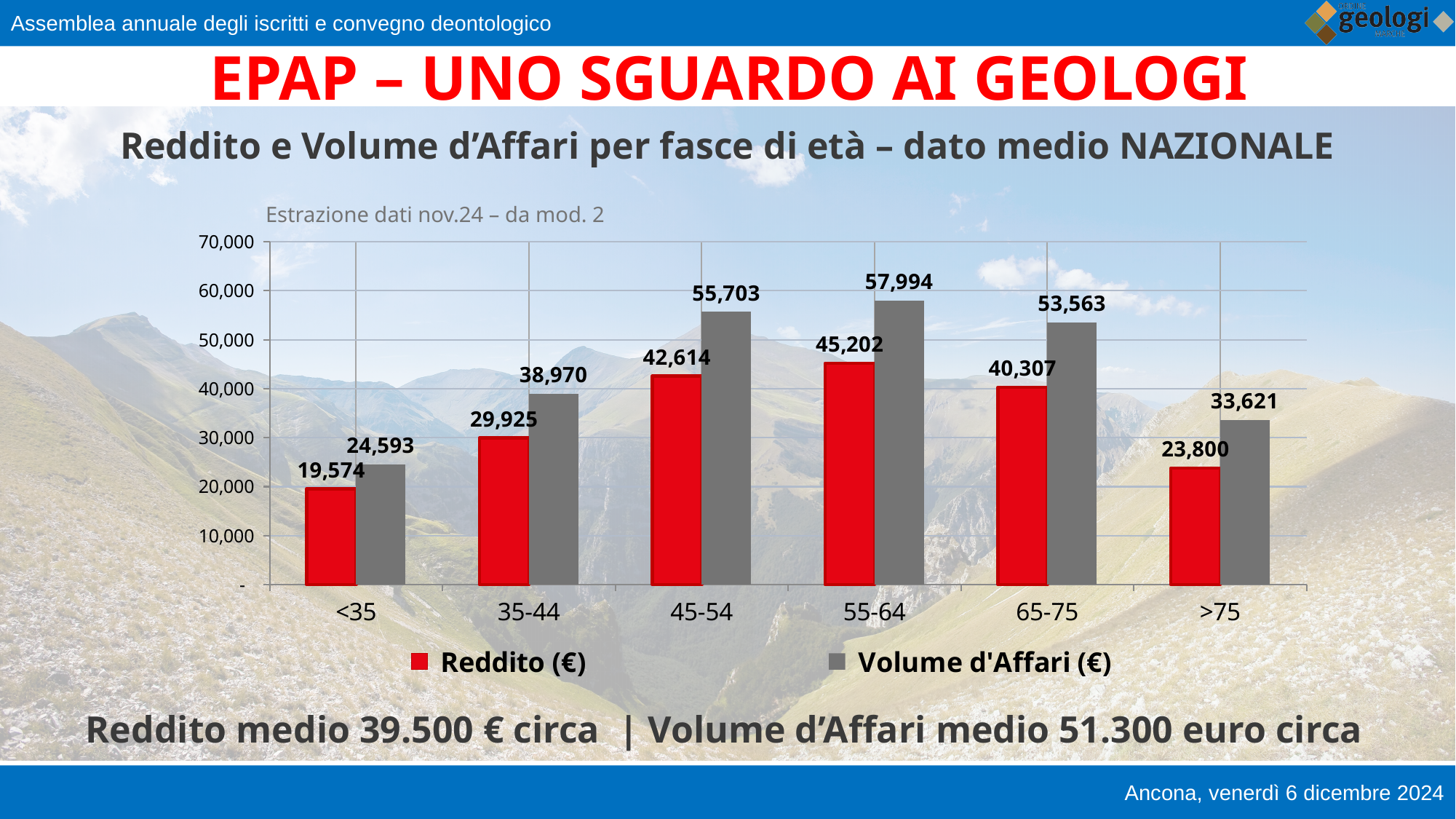
Which age group has the highest Volume d'Affari (€)? 55-64 What is the Volume d'Affari (€) value for the >75 age group? 33,621 How many age groups are shown on the x axis? 6 What kind of chart is shown on the slide? Bar chart What is the Reddito (€) value for the <35 age group? 19,574 What is the Reddito (€) value for the 45-54 age group? 42,614 What is the difference between Volume d'Affari (€) and Reddito (€) for the <35 age group? 5,019 How many series does the legend list? 2 Which is larger: the Reddito (€) for 65-75 or the Reddito (€) for 35-44? 65-75 Which colour represents Reddito (€) in the chart? Red Which age group has the lowest Reddito (€)? <35 What is the difference between Volume d'Affari (€) and Reddito (€) for the 55-64 age group? 12,792